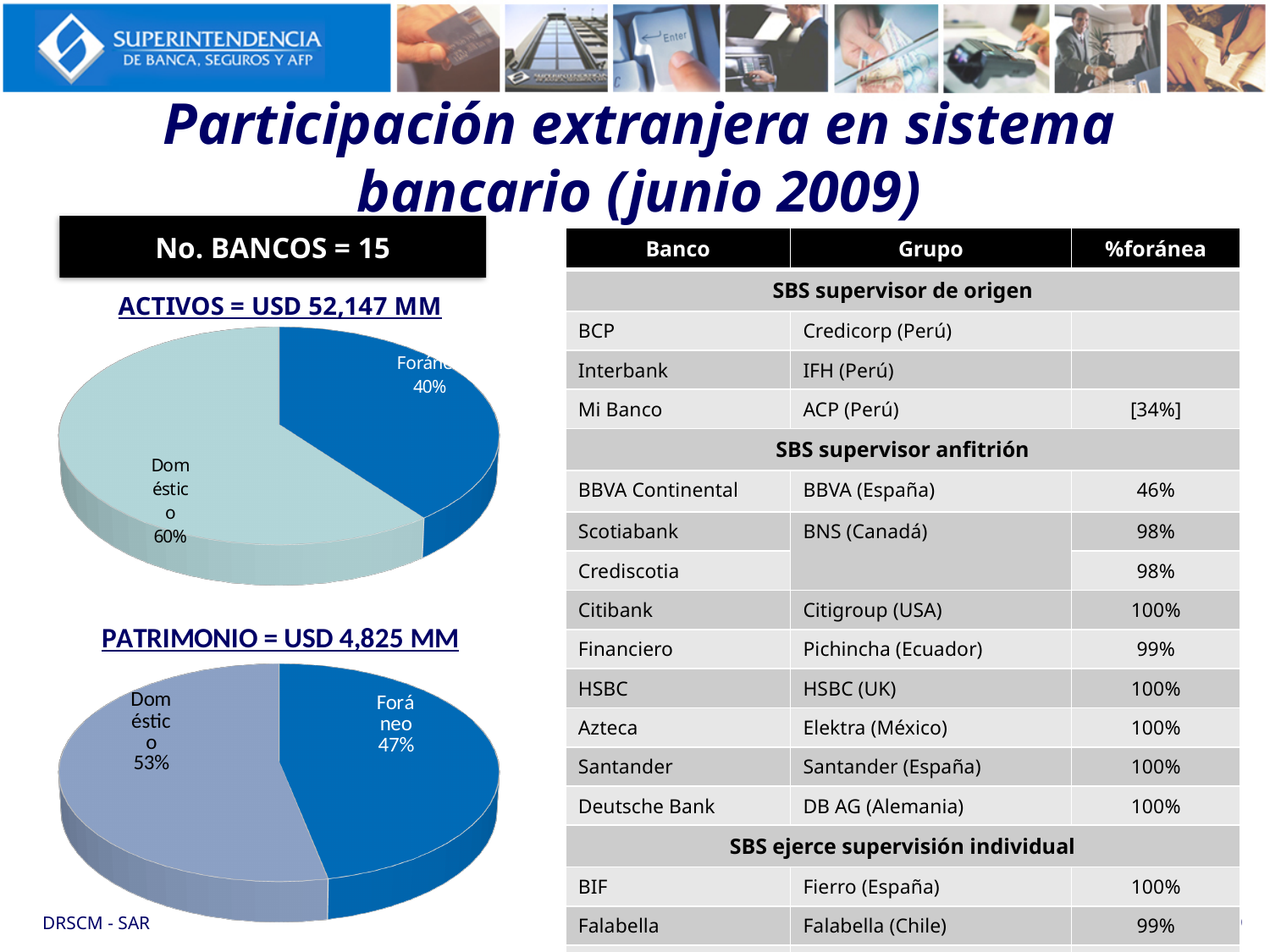
In the PATRIMONIO = USD 4,825 MM chart, what is the difference in percentage points between the Doméstico and Foráneo slices? 6 What is the title of the lower pie chart on the slide? PATRIMONIO = USD 4,825 MM In the ACTIVOS = USD 52,147 MM chart, what share is labelled Foráneo? 40% In the PATRIMONIO = USD 4,825 MM chart, what share is labelled Foráneo? 47% Is the Foráneo share larger in the ACTIVOS chart or in the PATRIMONIO chart? PATRIMONIO In the PATRIMONIO = USD 4,825 MM chart, which slice is the smallest? Foráneo How many slices does the PATRIMONIO = USD 4,825 MM chart have? 2 In the ACTIVOS = USD 52,147 MM chart, which slice is the largest? Doméstico What kind of chart is the ACTIVOS = USD 52,147 MM chart? Pie chart In the ACTIVOS = USD 52,147 MM chart, what share is labelled Doméstico? 60% In the PATRIMONIO = USD 4,825 MM chart, what share is labelled Doméstico? 53% In the ACTIVOS = USD 52,147 MM chart, what is the difference in percentage points between the Doméstico and Foráneo slices? 20